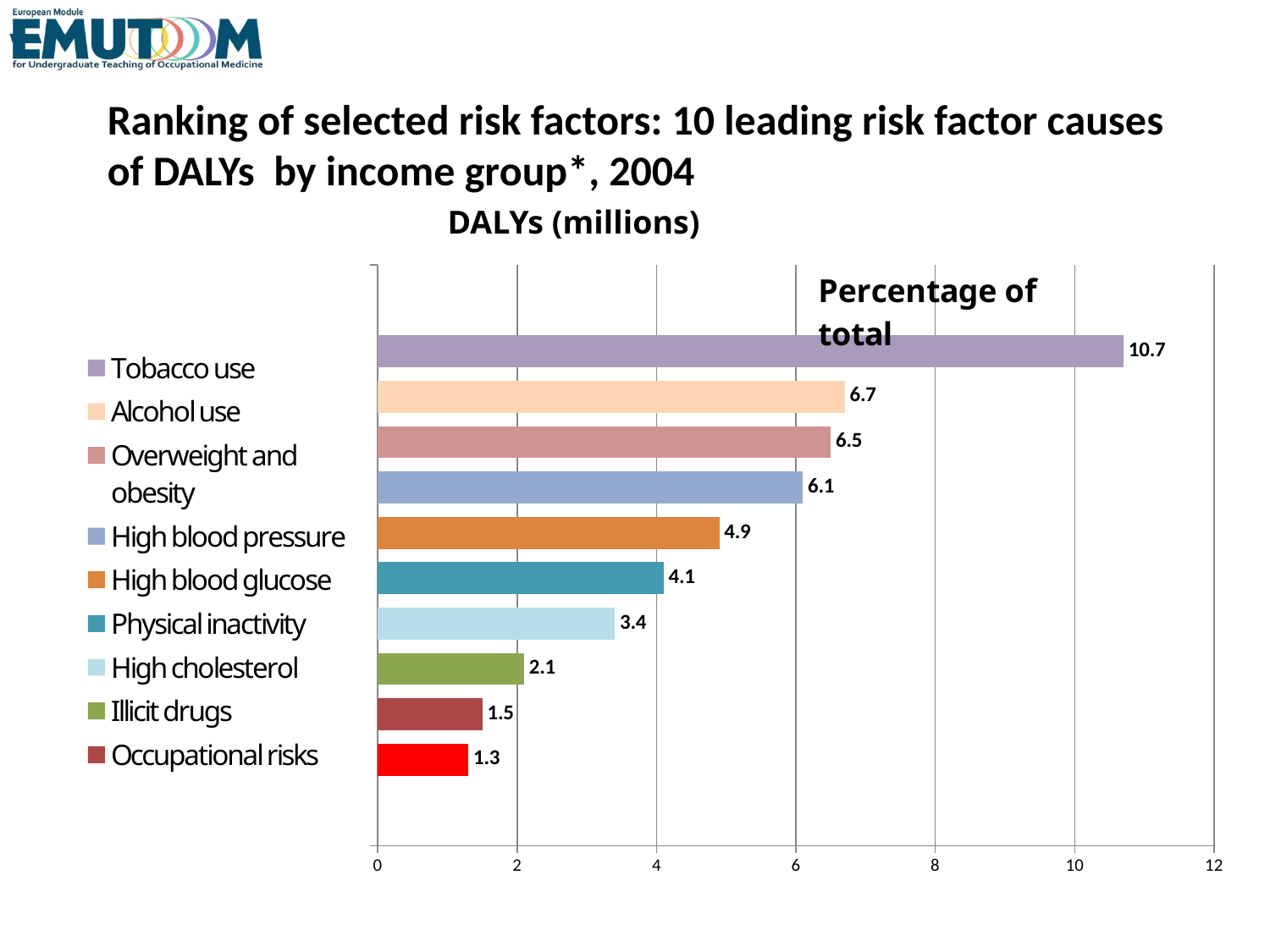
Which risk factor has the highest value? Tobacco use What is the difference between the values for Tobacco use and Alcohol use? 4.0 Which is larger, the value for Overweight and obesity or the value for High blood pressure? Overweight and obesity How many entries does the legend list? 9 What is the value for Tobacco use? 10.7 What is the value for High blood pressure? 6.1 What is the difference between the values for High blood glucose and High cholesterol? 1.5 How many bars are plotted in the chart? 10 What is the value for Alcohol use? 6.7 What is the value for Physical inactivity? 4.1 What is the value for Illicit drugs? 2.1 What kind of chart is shown on the slide? Bar chart